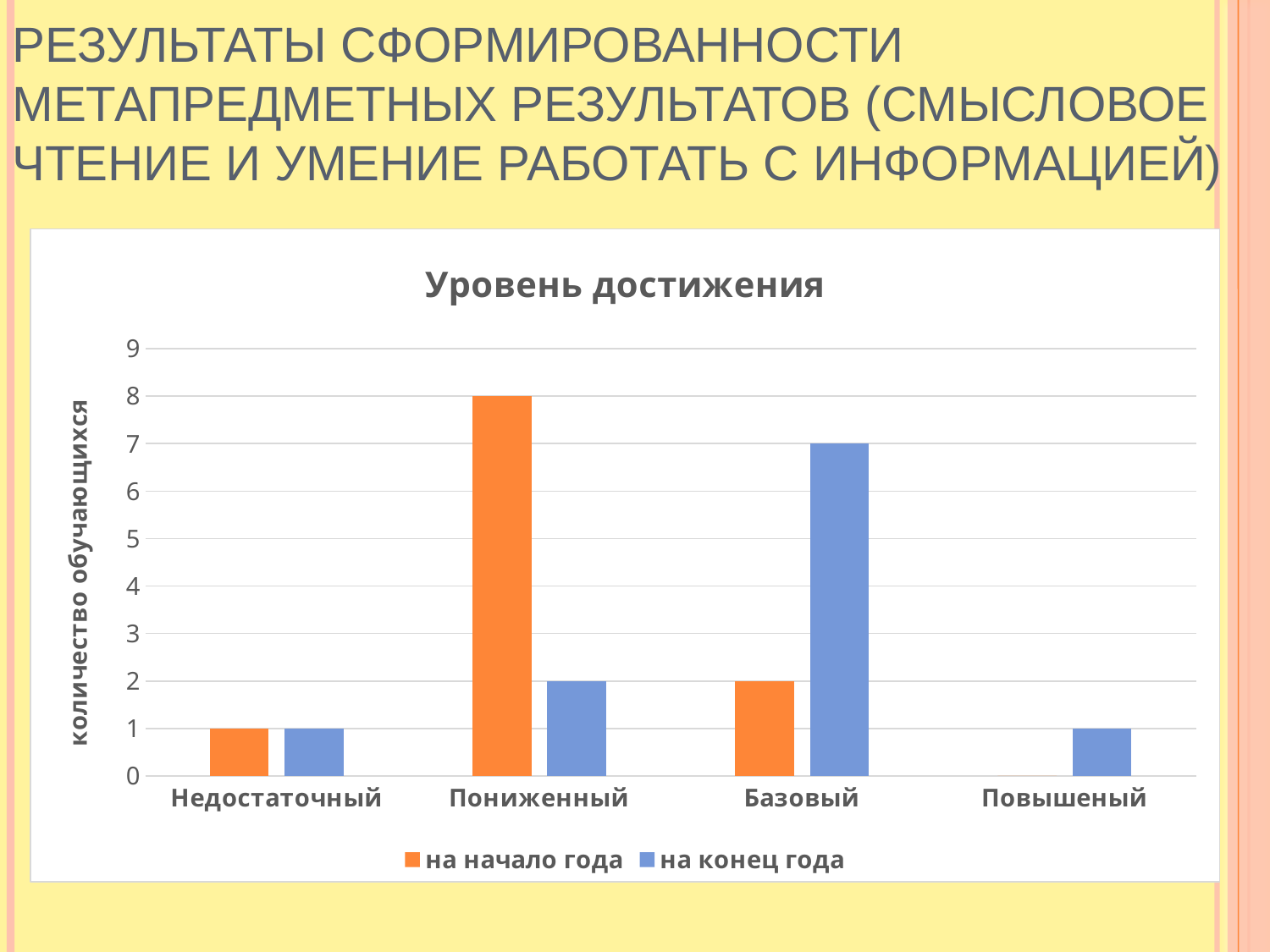
For Базовый, which series has the larger value: на начало года or на конец года? на конец года How many series does the legend list? 2 What is the title of the chart? Уровень достижения What is the value for Базовый in the series на конец года? 7 Which category has the highest value in the series на начало года? Пониженный Which category has the highest value in the series на конец года? Базовый How many categories are shown on the x axis? 4 What is the value for Пониженный in the series на начало года? 8 What kind of chart is shown on the slide? bar chart What is the label of the y axis? количество обучающихся What is the difference between the на начало года and на конец года values for Пониженный? 6 What is the value for Повышеный in the series на конец года? 1